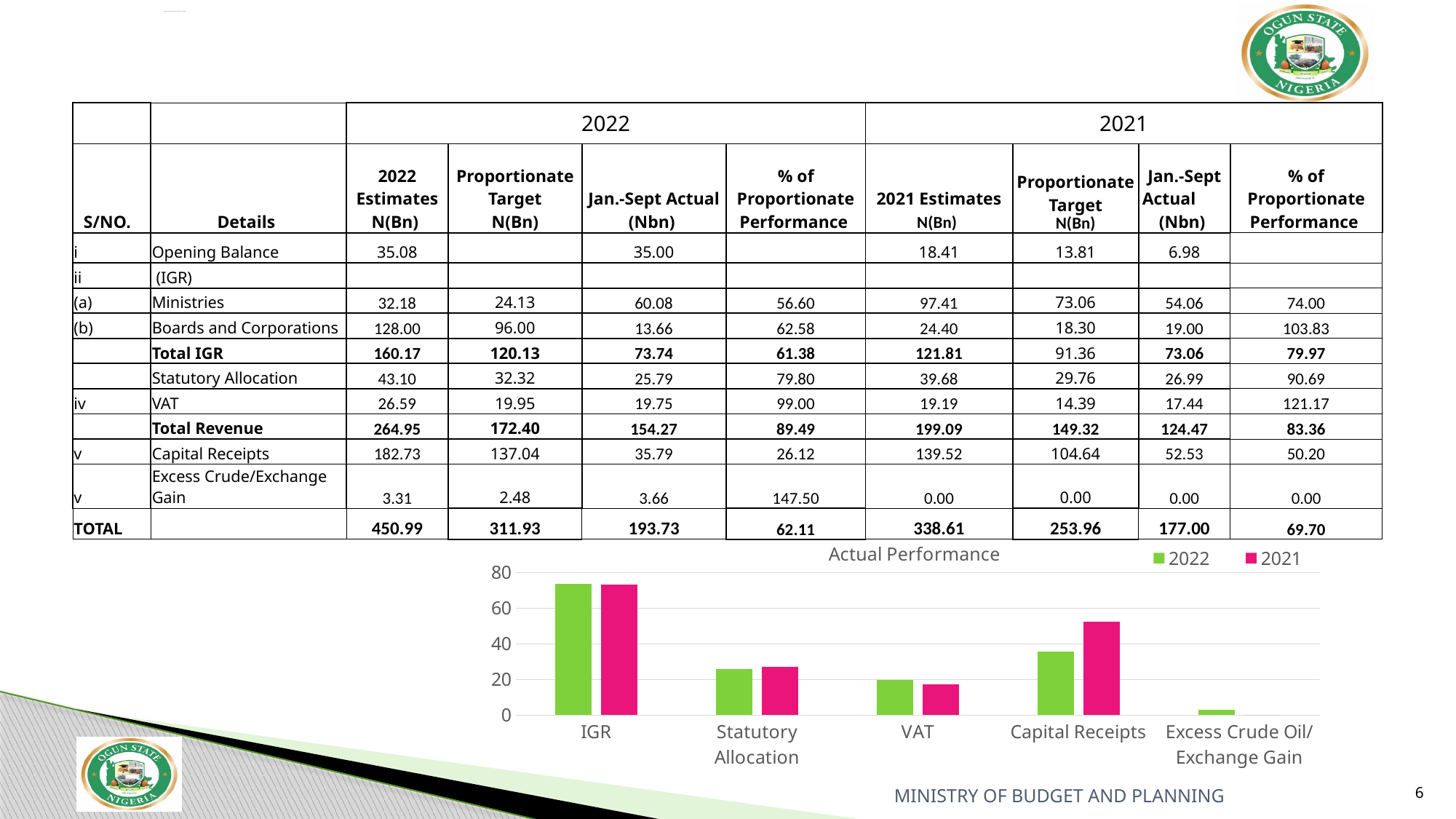
Which category has the highest 2022 bar in the chart? IGR Which category has the highest 2021 bar in the chart? IGR What is the title of the chart? Actual Performance What kind of chart is shown at the bottom of the slide? bar chart Is the 2022 value for IGR greater or less than 60? greater How many categories are shown on the x axis of the chart? 5 How many series does the chart legend list? 2 Which colour represents the 2021 series in the chart? pink Is the 2021 value for VAT greater or less than 20? less Which category has the lowest 2022 bar in the chart? Excess Crude Oil/ Exchange Gain Is the 2021 value for Capital Receipts greater or less than 40? greater For Capital Receipts, which series has the larger bar, 2022 or 2021? 2021